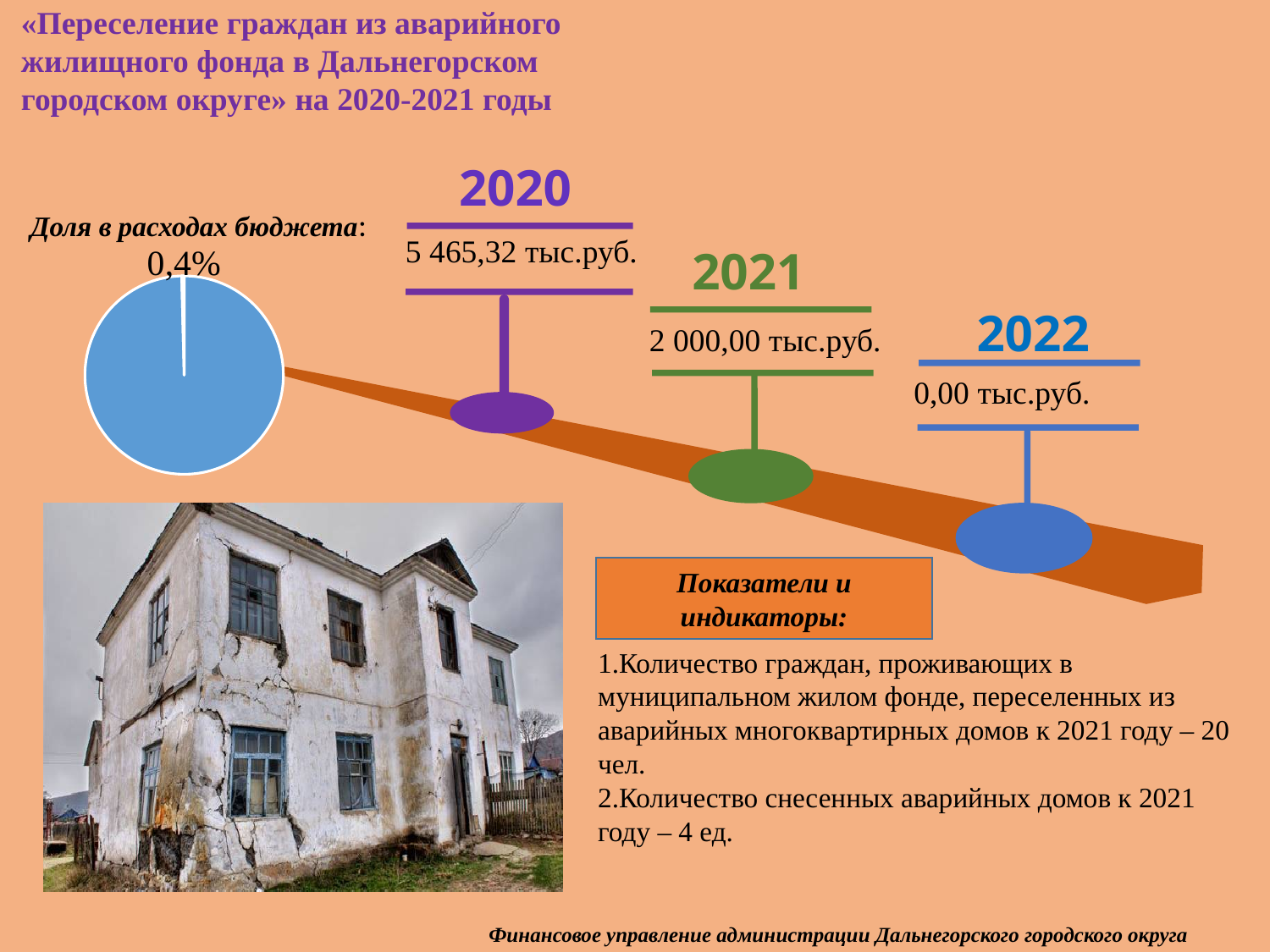
On the timeline graphic, what amount is shown for 2022? 0,00 тыс.руб. What kind of chart is shown under the heading «Доля в расходах бюджета»? pie chart On the timeline graphic, which year has the larger amount, 2021 or 2022? 2021 What colour is the large slice of the pie chart? blue On the timeline graphic, which year has the highest amount? 2020 In the pie chart, what share of budget expenditure does the programme account for? 0,4% What is the heading printed above the pie chart? Доля в расходах бюджета On the timeline graphic, what amount is shown for 2021? 2 000,00 тыс.руб. On the timeline graphic, what is the difference between the 2020 and 2021 amounts? 3 465,32 тыс.руб. On the timeline graphic, do the amounts rise or fall from 2020 to 2022? fall On the timeline graphic, which year has the lowest amount? 2022 On the timeline graphic, what amount is shown for 2020? 5 465,32 тыс.руб.